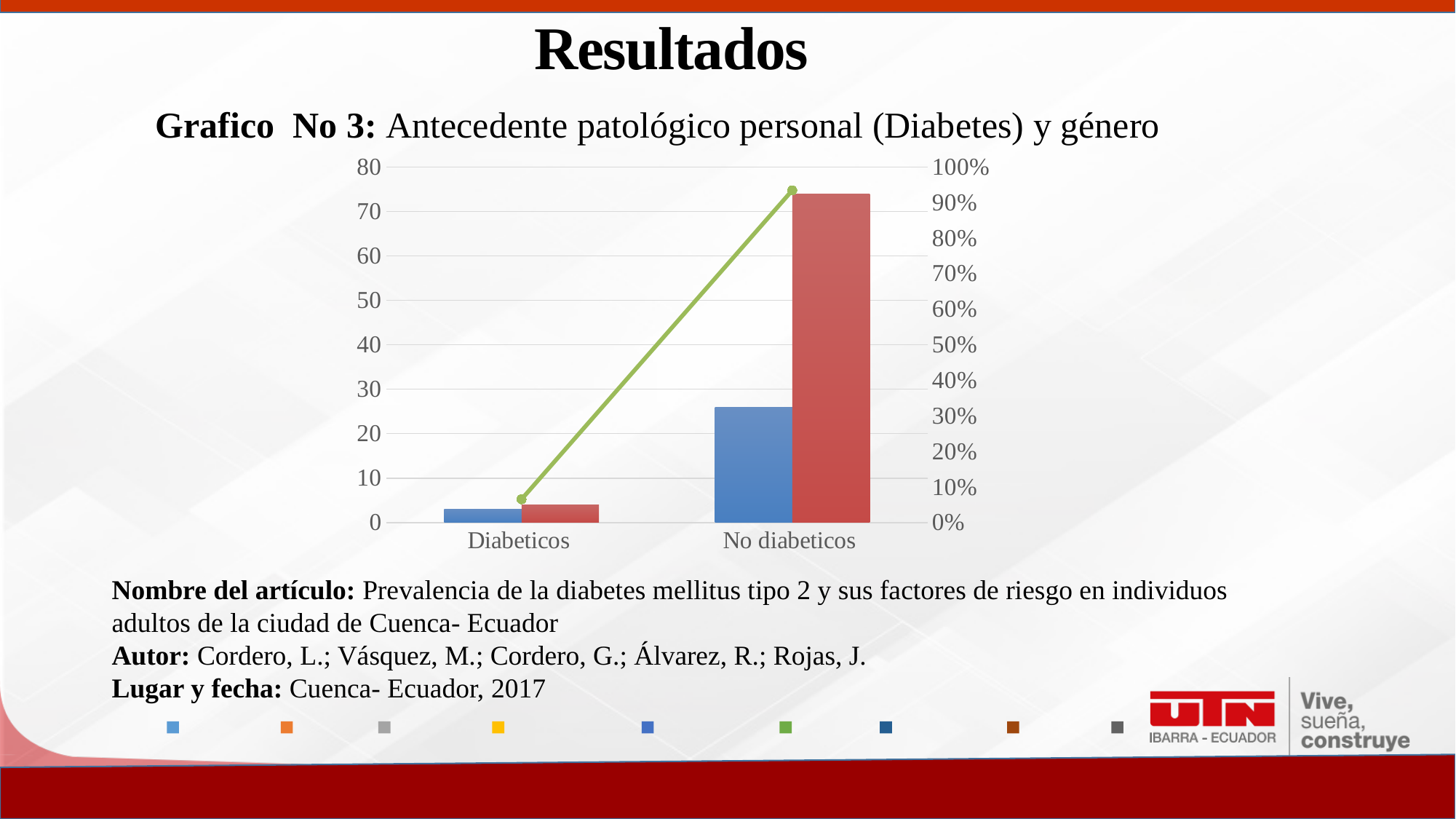
What is the title of the chart (Grafico No 3)? Antecedente patológico personal (Diabetes) y género Is the value of the blue bar for Diabeticos greater or less than 10? less How many categories are shown on the x axis of the chart? 2 Which category has the shorter blue bar? Diabeticos Is the green line value for Diabeticos greater or less than 10%? less Which category has the taller red bar? No diabeticos Does the green line rise or fall from Diabeticos to No diabeticos? rise What kind of chart is shown on the slide? combination bar and line chart Is the green line value for No diabeticos greater or less than 80%? greater For No diabeticos, which bar is taller, the blue bar or the red bar? red bar